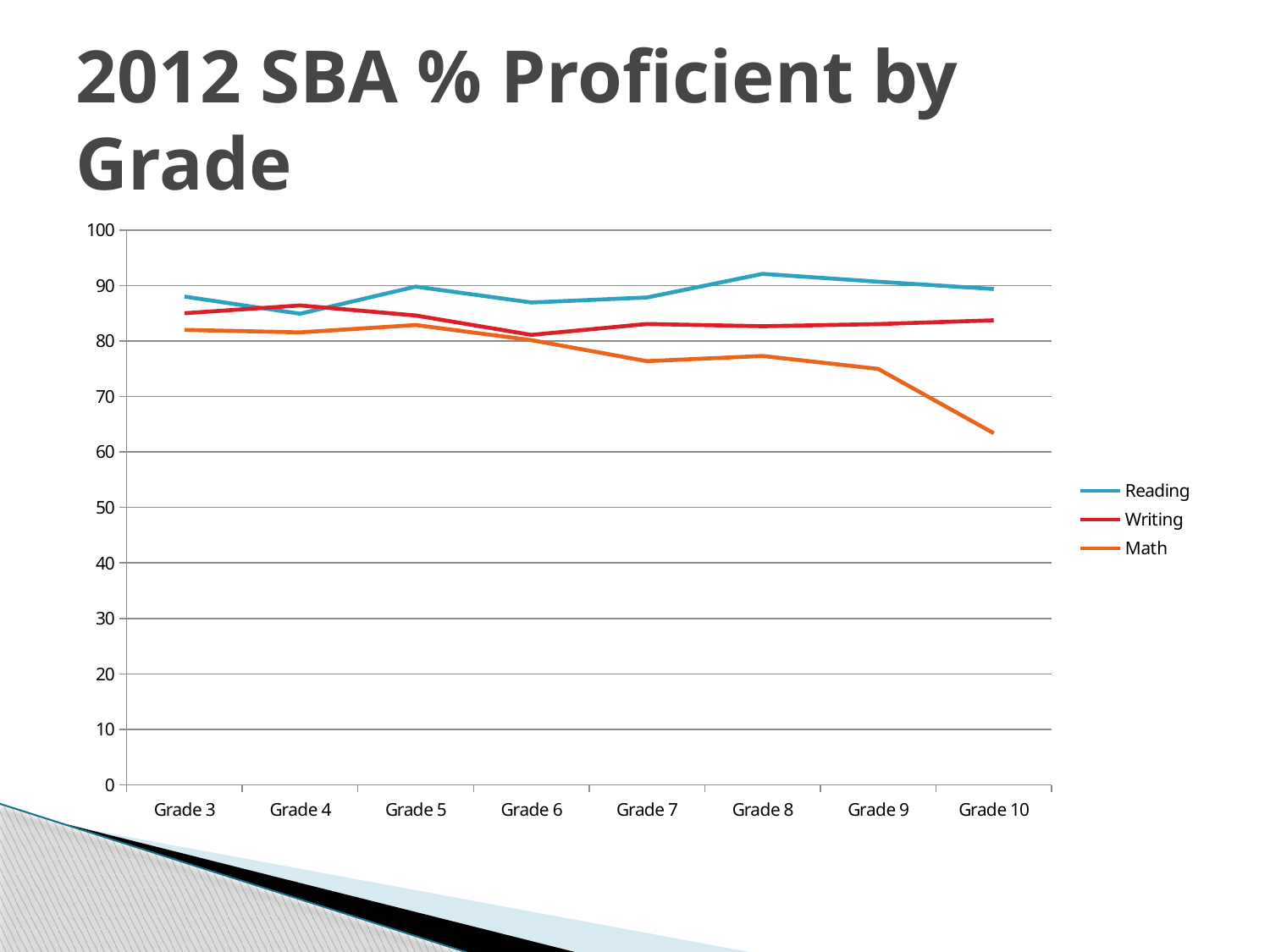
What kind of chart is shown on the slide? line chart How many series does the legend list? 3 Is the Math value for Grade 10 greater or less than 70? less At which grade is the Reading series highest? Grade 8 At Grade 10, which is larger, Reading or Math? Reading Is the Reading value for Grade 8 greater or less than 90? greater Is the Writing value for Grade 6 greater or less than 90? less At which grade is the Math series lowest? Grade 10 What is the title of the slide? 2012 SBA % Proficient by Grade Does the Math series rise or fall overall from Grade 3 to Grade 10? fall How many grades are plotted along the x axis? 8